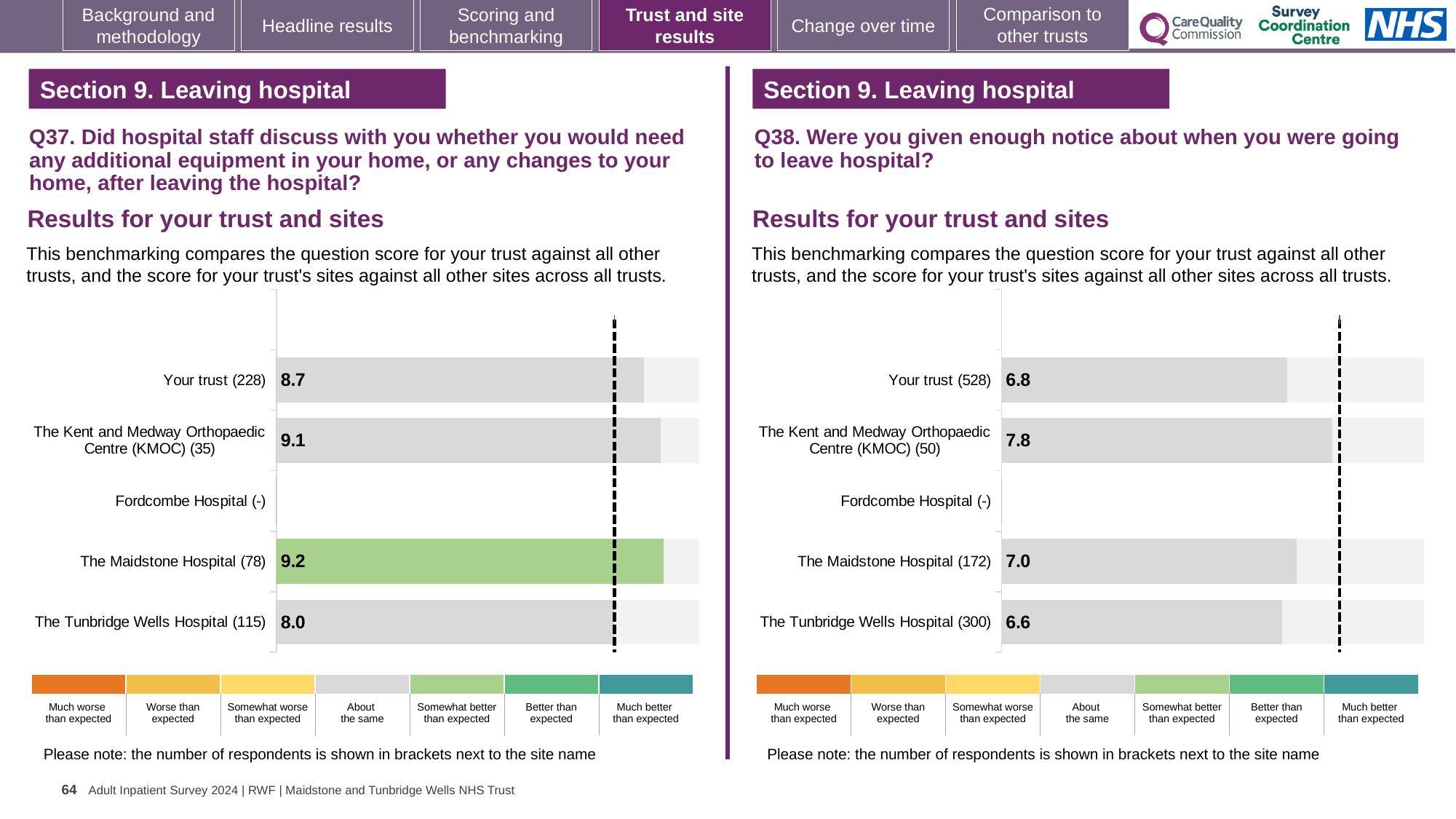
In the Q38 chart on the right, what is the difference between the scores for The Kent and Medway Orthopaedic Centre (KMOC) and Your trust? 1.0 In the Q37 chart on the left, what is the difference between the scores for The Maidstone Hospital and The Tunbridge Wells Hospital? 1.2 In the Q37 chart on the left, what is the score for The Maidstone Hospital? 9.2 How many sites or categories are listed on the y axis of the Q38 chart on the right? 5 In the Q37 chart on the left, what is the score for Your trust? 8.7 In the Q38 chart on the right, which site has the highest score? The Kent and Medway Orthopaedic Centre (KMOC) In the Q37 chart on the left, which bar is coloured green rather than grey? The Maidstone Hospital What type of chart is used for the Q37 results on the left? Bar chart In the Q38 chart on the right, what is the score for The Kent and Medway Orthopaedic Centre (KMOC)? 7.8 In the Q37 chart on the left, which site has the lowest score? The Tunbridge Wells Hospital In the Q38 chart on the right, what is the score for The Tunbridge Wells Hospital? 6.6 In the Q38 chart on the right, which is larger: the score for Your trust or the score for The Maidstone Hospital? The Maidstone Hospital